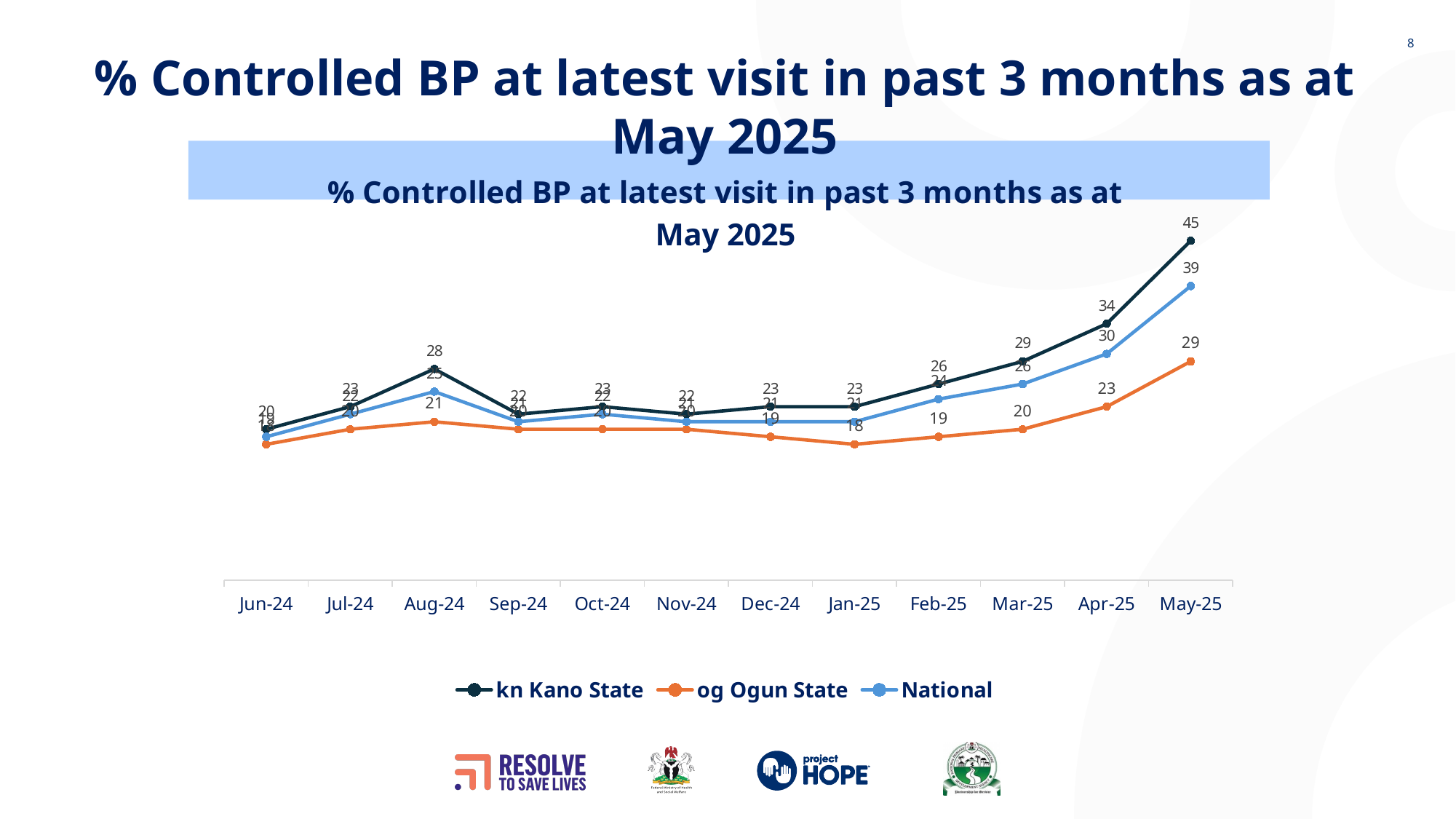
How many series does the legend list? 3 What is the value for og Ogun State in Apr-25? 23 What is the value for National in May-25? 39 What is the value for kn Kano State in May-25? 45 By how much did kn Kano State increase from Apr-25 to May-25? 11 How many months are shown on the x axis? 12 What kind of chart is shown on the slide? line chart Which is larger in Mar-25, kn Kano State or og Ogun State? kn Kano State What is the difference between kn Kano State and National in May-25? 6 In which month does kn Kano State reach its highest value? May-25 What is the value for og Ogun State in Jan-25? 18 In which month does National reach its highest value? May-25